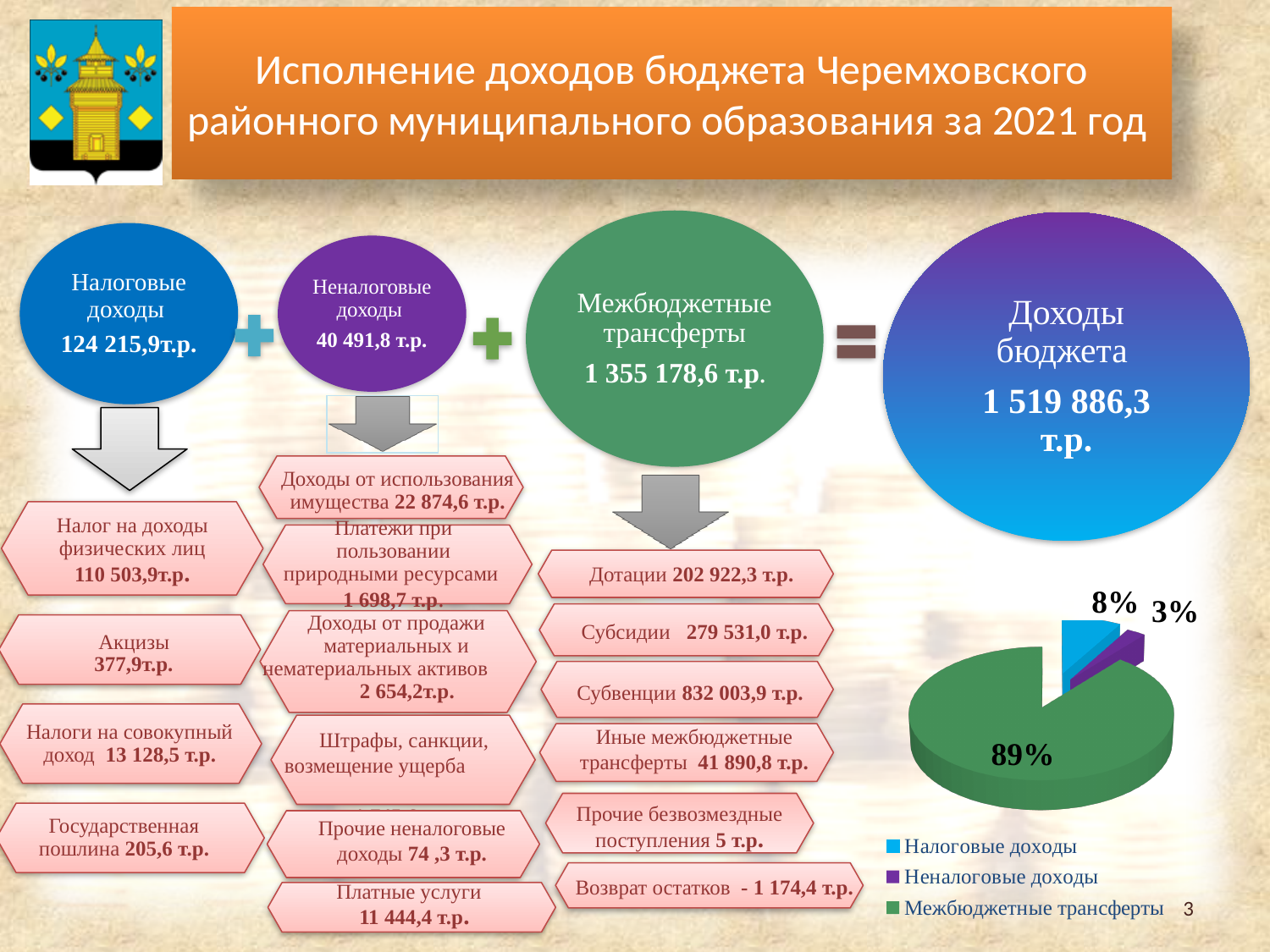
What share of the pie chart does Налоговые доходы have? 8% What colour is the Межбюджетные трансферты slice in the pie chart? green In the pie chart, which is larger: Налоговые доходы or Неналоговые доходы? Налоговые доходы Which slice of the pie chart is the smallest? Неналоговые доходы What share of the pie chart does Межбюджетные трансферты have? 89% What is the difference in percentage points between the Межбюджетные трансферты slice and the Налоговые доходы slice? 81 What kind of chart is shown on the slide? pie chart Which slice of the pie chart is the largest? Межбюджетные трансферты What share of the pie chart does Неналоговые доходы have? 3% How many slices does the pie chart have? 3 What is the difference in percentage points between the Налоговые доходы slice and the Неналоговые доходы slice? 5 How many entries does the legend of the pie chart list? 3